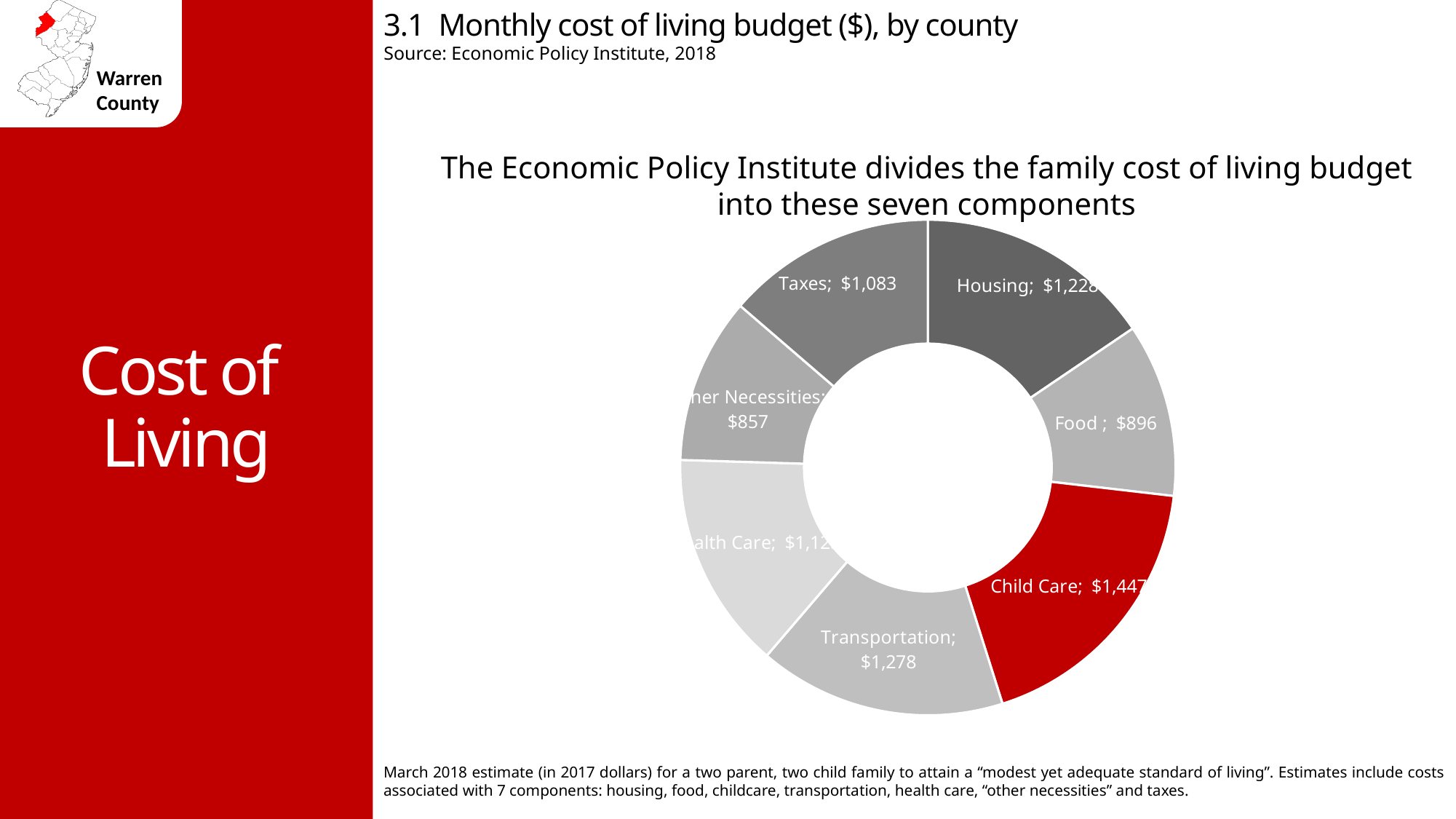
What is the monthly cost for Other Necessities? $857 What is the monthly cost for Taxes? $1,083 How many components are shown in the chart? 7 Which component has the largest monthly cost? Child Care Which is larger, the cost for Taxes or the cost for Food? Taxes Which component has the smallest monthly cost? Other Necessities What is the monthly cost for Transportation? $1,278 What is the monthly cost for Food? $896 What type of chart is shown on the slide? Pie (doughnut) chart Which slice of the chart is coloured red? Child Care What is the monthly cost for Child Care? $1,447 What is the difference between the Transportation and Taxes costs? $195